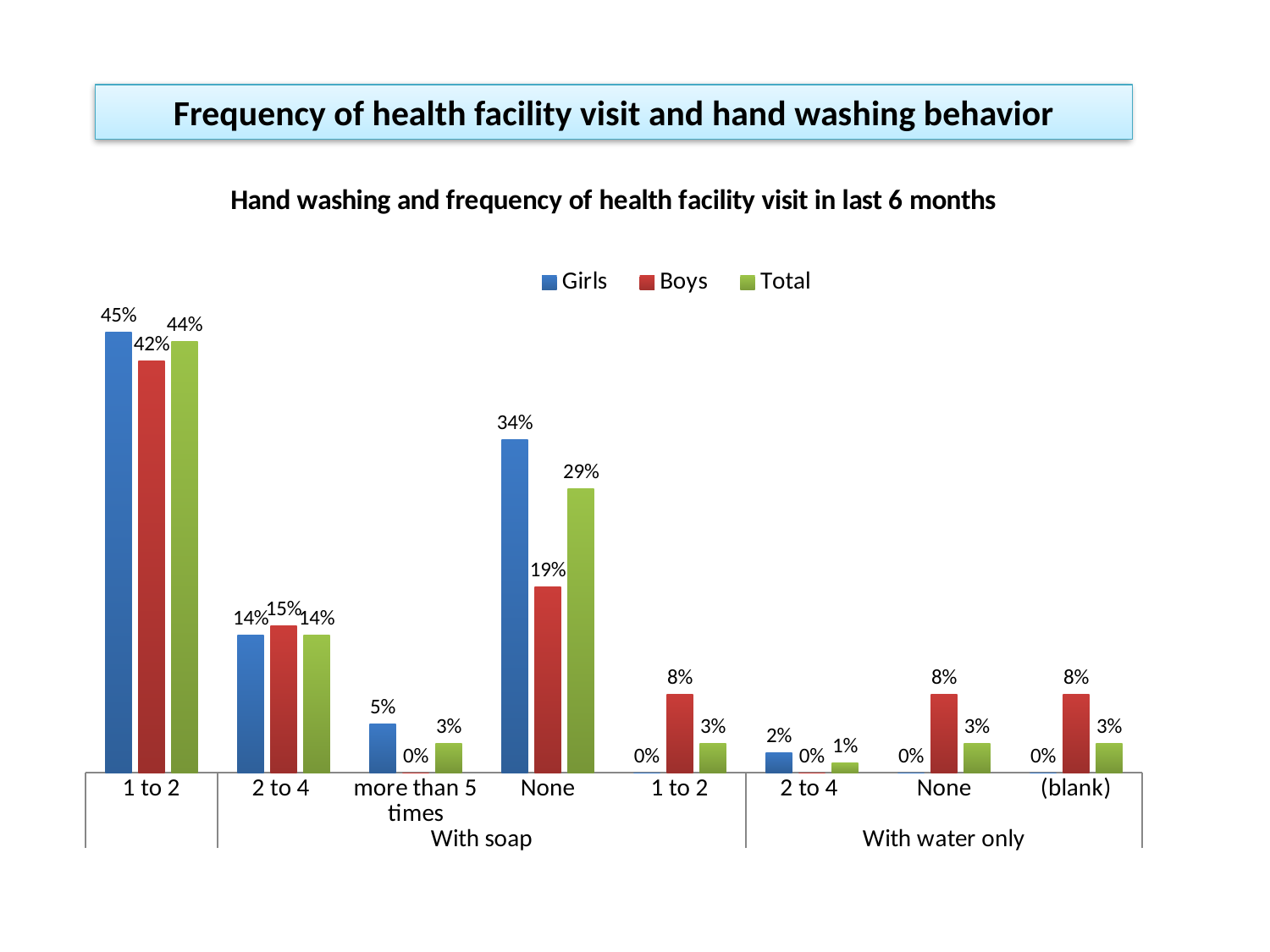
What is the title of the chart? Hand washing and frequency of health facility visit in last 6 months What is the Total value for the '2 to 4' category under 'With water only'? 1% Which category has the highest Total value? 1 to 2 (leftmost) What is the Boys value for the 'None' category under 'With soap'? 19% How many series does the legend list? 3 What type of chart is shown on the slide? bar chart What is the difference between the Girls and Boys values for the leftmost '1 to 2' category? 3% What is the Girls value for the leftmost '1 to 2' category? 45% What is the Girls value for the 'None' category under 'With soap'? 34% How many categories are shown along the x axis? 8 Which is larger for the 'more than 5 times' category under 'With soap': the Girls value or the Total value? Girls What is the difference between the Girls and Boys values for the 'None' category under 'With soap'? 15%